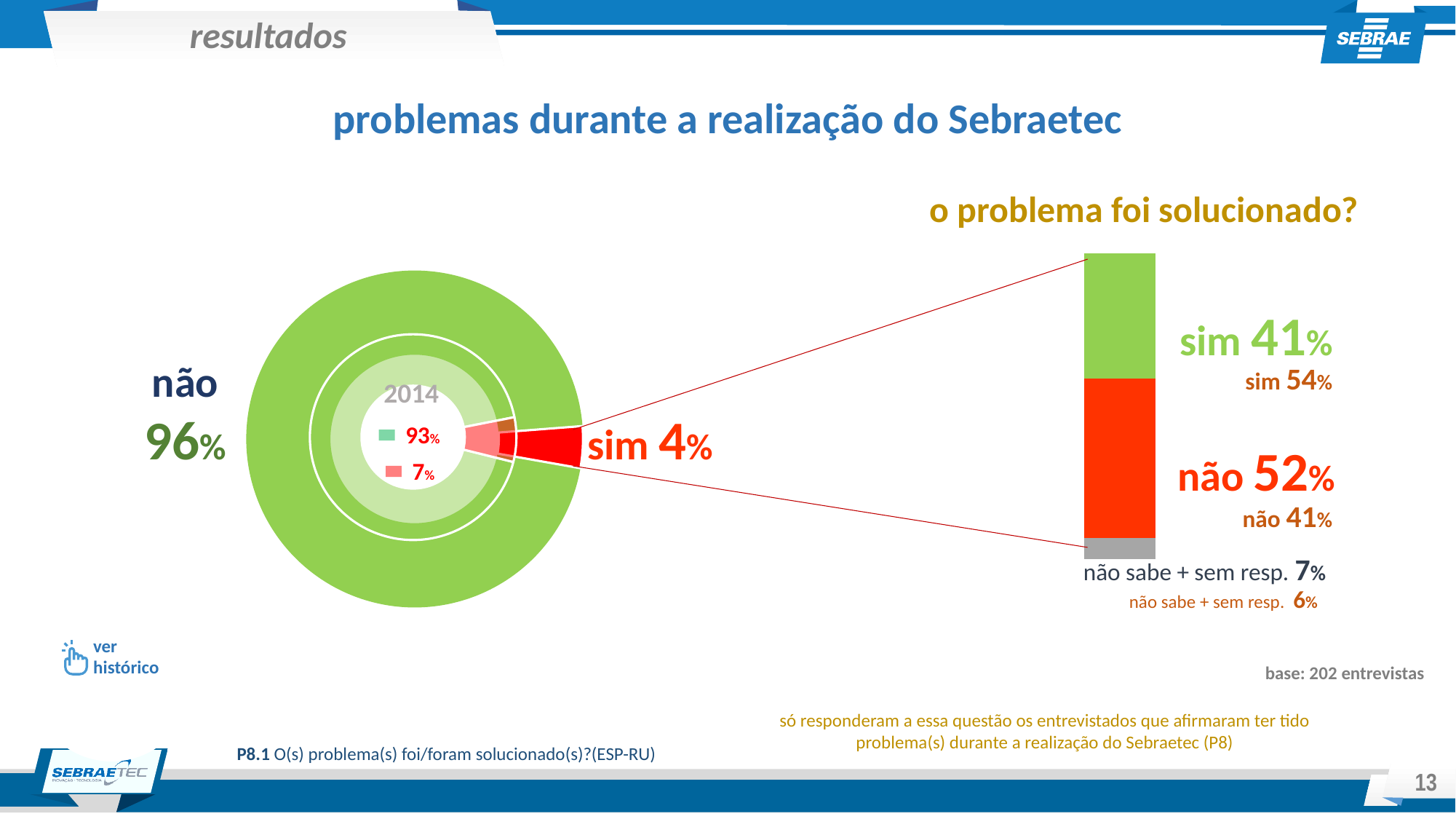
In the pie chart on the left, what percentage of respondents answered "não" (no problems during the Sebraetec)? 96% In the pie chart on the left, what was the "sim" share in the inner 2014 ring? 7% In the pie chart on the left, what percentage of respondents answered "sim"? 4% In the stacked bar on the right, what percentage is "não sabe + sem resp."? 7% What type of chart is shown on the left of the slide? Doughnut chart In the stacked bar on the right, which segment is the largest? não In the pie chart on the left, which category has the largest slice? não In the stacked bar on the right ("o problema foi solucionado?"), what percentage answered "sim"? 41% In the pie chart on the left, what was the "não" share in the inner 2014 ring? 93% In the stacked bar on the right ("o problema foi solucionado?"), what percentage answered "não"? 52% In the pie chart on the left, what is the difference between the "não" and "sim" shares? 92 percentage points